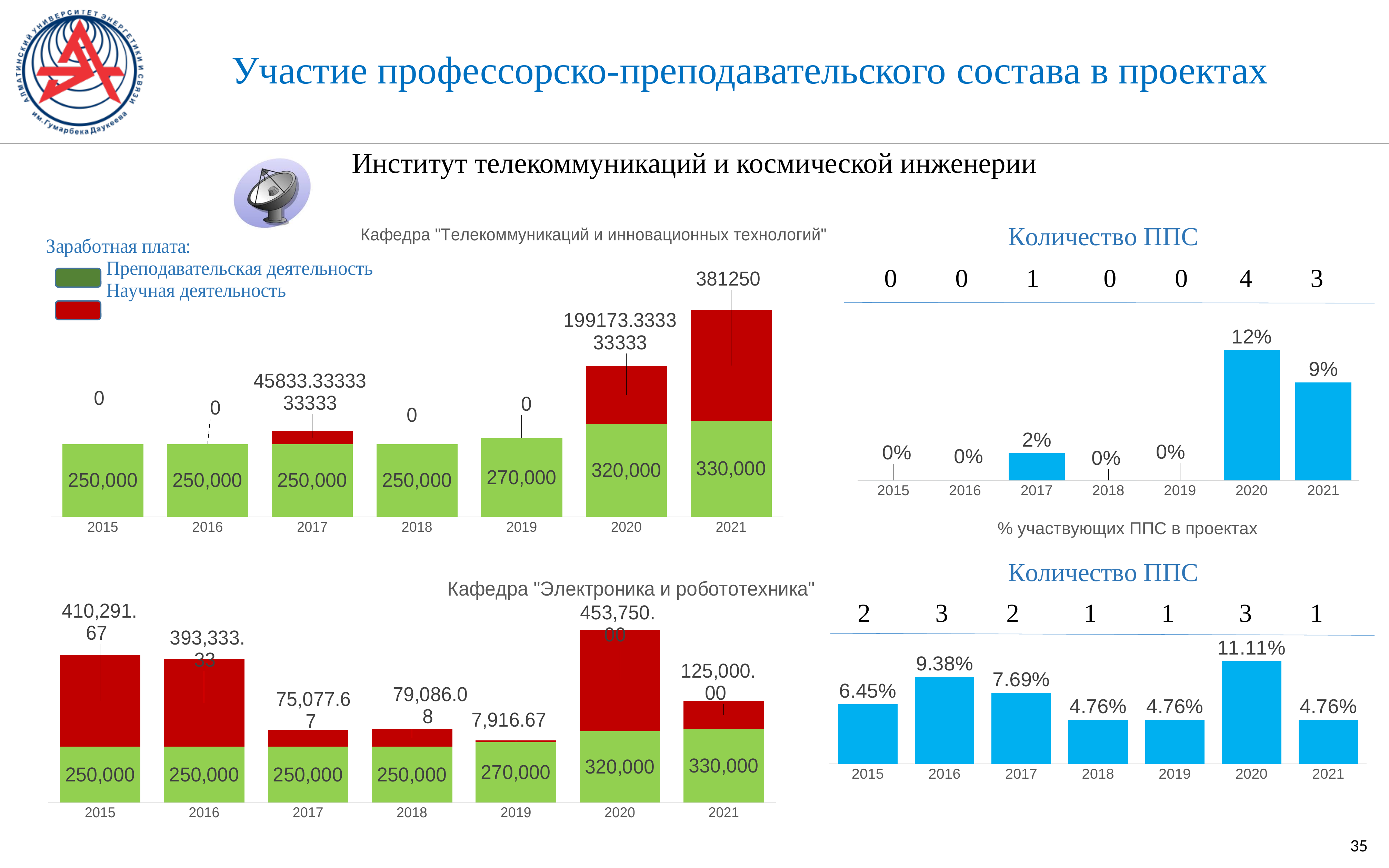
In the bottom-right chart titled "Количество ППС", which year has the highest percentage? 2020 In the chart for Кафедра "Телекоммуникаций и инновационных технологий", what is the value of the red (Научная деятельность) segment for 2021? 381250 In the bottom-right chart titled "Количество ППС", what is the value for 2016? 9.38% In the chart for Кафедра "Электроника и робототехника", which year has the lowest red (Научная деятельность) value? 2019 In the chart for Кафедра "Электроника и робототехника", what is the total of the stacked bar for 2021? 455,000 In the bottom-right chart titled "Количество ППС", what is the difference between the values for 2020 and 2021? 6.35% In the chart for Кафедра "Телекоммуникаций и инновационных технологий", what is the value of the green (Преподавательская деятельность) segment for 2019? 270,000 What type of chart is the top-right chart titled "Количество ППС"? Bar chart In the top-right chart titled "Количество ППС" (% участвующих ППС в проектах), what is the value for 2020? 12% In the chart for Кафедра "Электроника и робототехника", what is the value of the red (Научная деятельность) segment for 2020? 453,750.00 In the top-right chart titled "Количество ППС", which year has the highest percentage? 2020 How many years are shown on the x axis of the chart for Кафедра "Электроника и робототехника"? 7